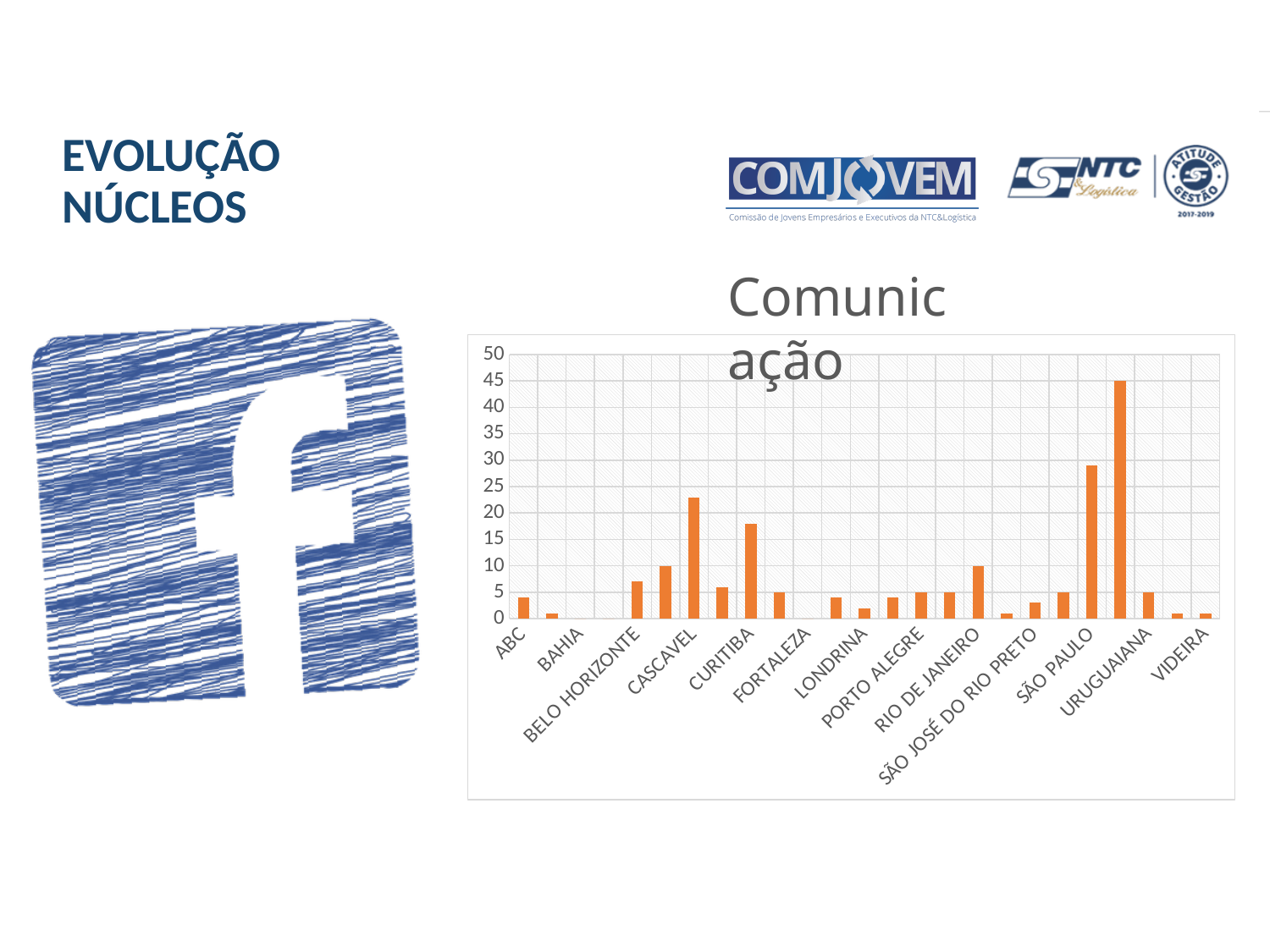
Is the value for CURITIBA greater or less than 15? greater Is the value for RIO DE JANEIRO greater or less than 15? less Is the value for CASCAVEL greater or less than 20? greater Which has the larger value, SÃO PAULO or VIDEIRA? SÃO PAULO What colour are the bars in the chart? orange What is the highest value shown on the vertical axis? 50 What kind of chart is shown on the slide? bar chart What is the title of the chart? Comunicação Which has the larger value, SÃO PAULO or CASCAVEL? SÃO PAULO Which has the larger value, CASCAVEL or CURITIBA? CASCAVEL